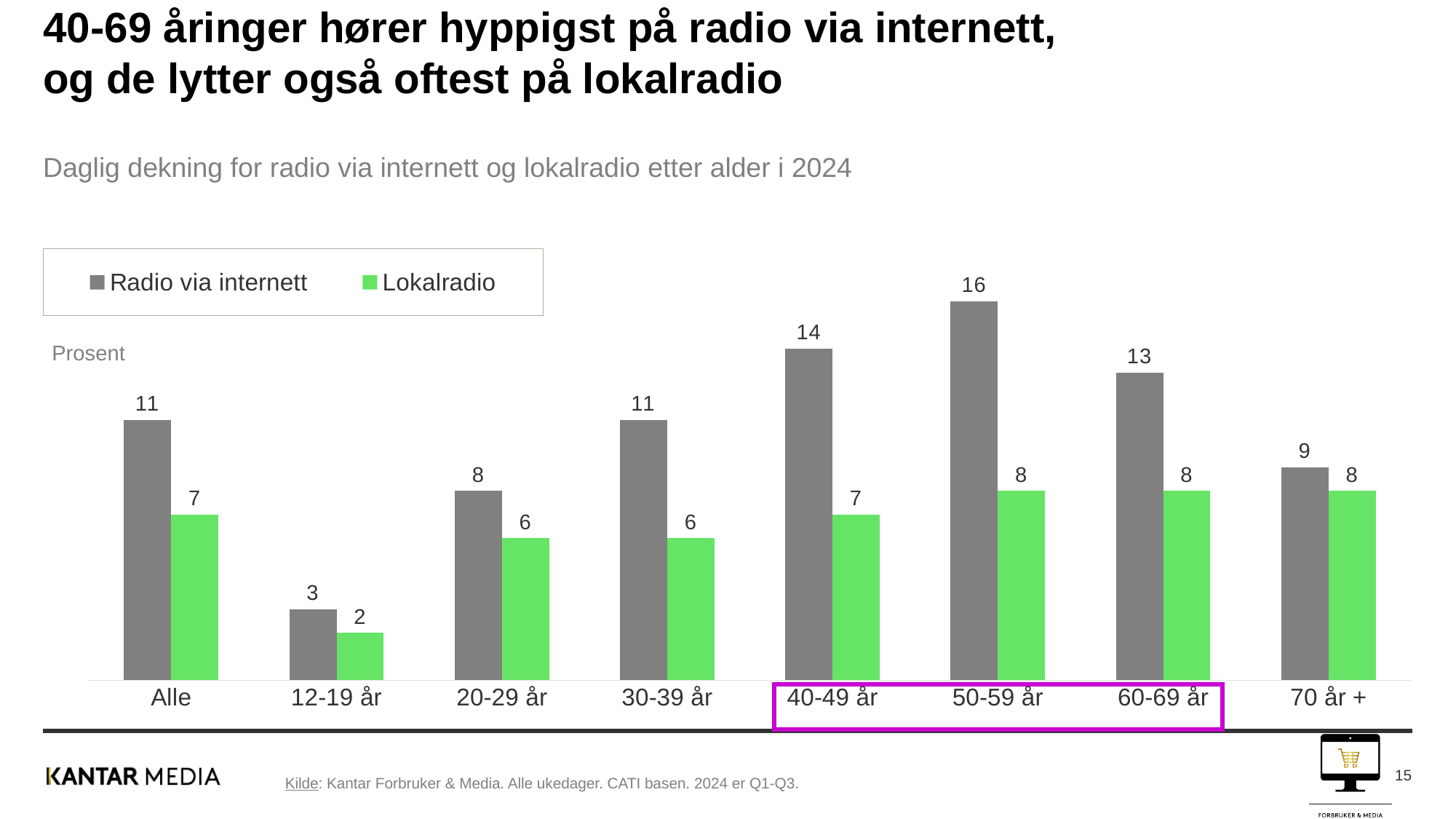
What unit is indicated for the values on the chart? Prosent How many age categories are shown on the x axis? 8 What is the value for Radio via internett for the Alle category? 11 Which is larger for the 70 år + age group: Radio via internett or Lokalradio? Radio via internett Which age group has the lowest value for Lokalradio? 12-19 år What kind of chart is shown on the slide? Bar chart Which colour represents Lokalradio in the legend? Green Which age group has the highest value for Radio via internett? 50-59 år What is the value for Lokalradio for the 12-19 år age group? 2 What is the difference between Radio via internett and Lokalradio for the 40-49 år age group? 7 What is the value for Radio via internett for the 50-59 år age group? 16 How many series does the legend list? 2